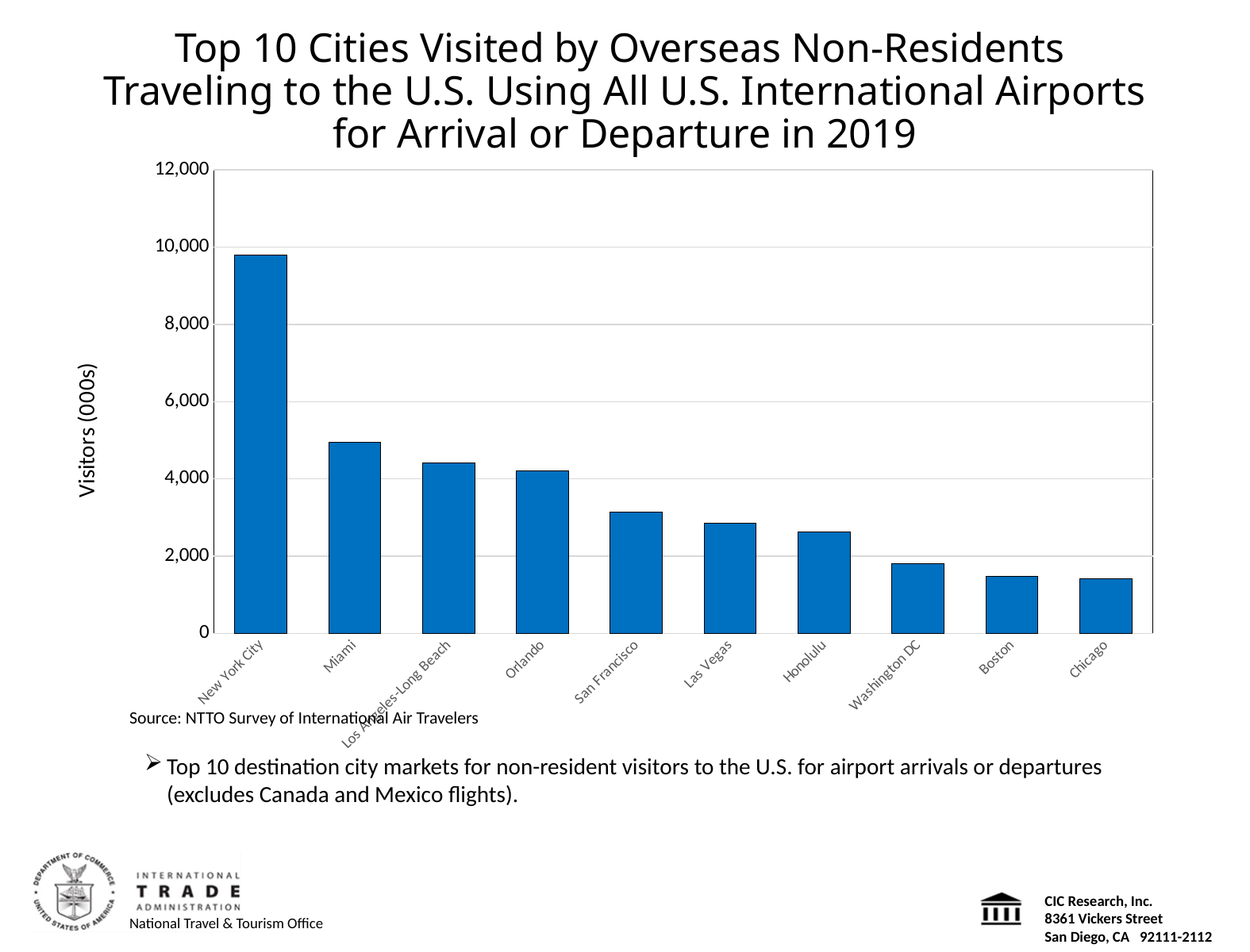
How many cities are shown on the chart? 10 Is the value for Chicago greater or less than 2,000? less Which city has the highest number of visitors? New York City Is the value for New York City greater or less than 8,000? greater Is the value for San Francisco greater or less than 2,000? greater Do the values rise or fall moving from left to right along the x axis? fall What kind of chart is shown on the slide? bar chart What is the label on the vertical axis of the chart? Visitors (000s) Which has more visitors, Miami or Las Vegas? Miami